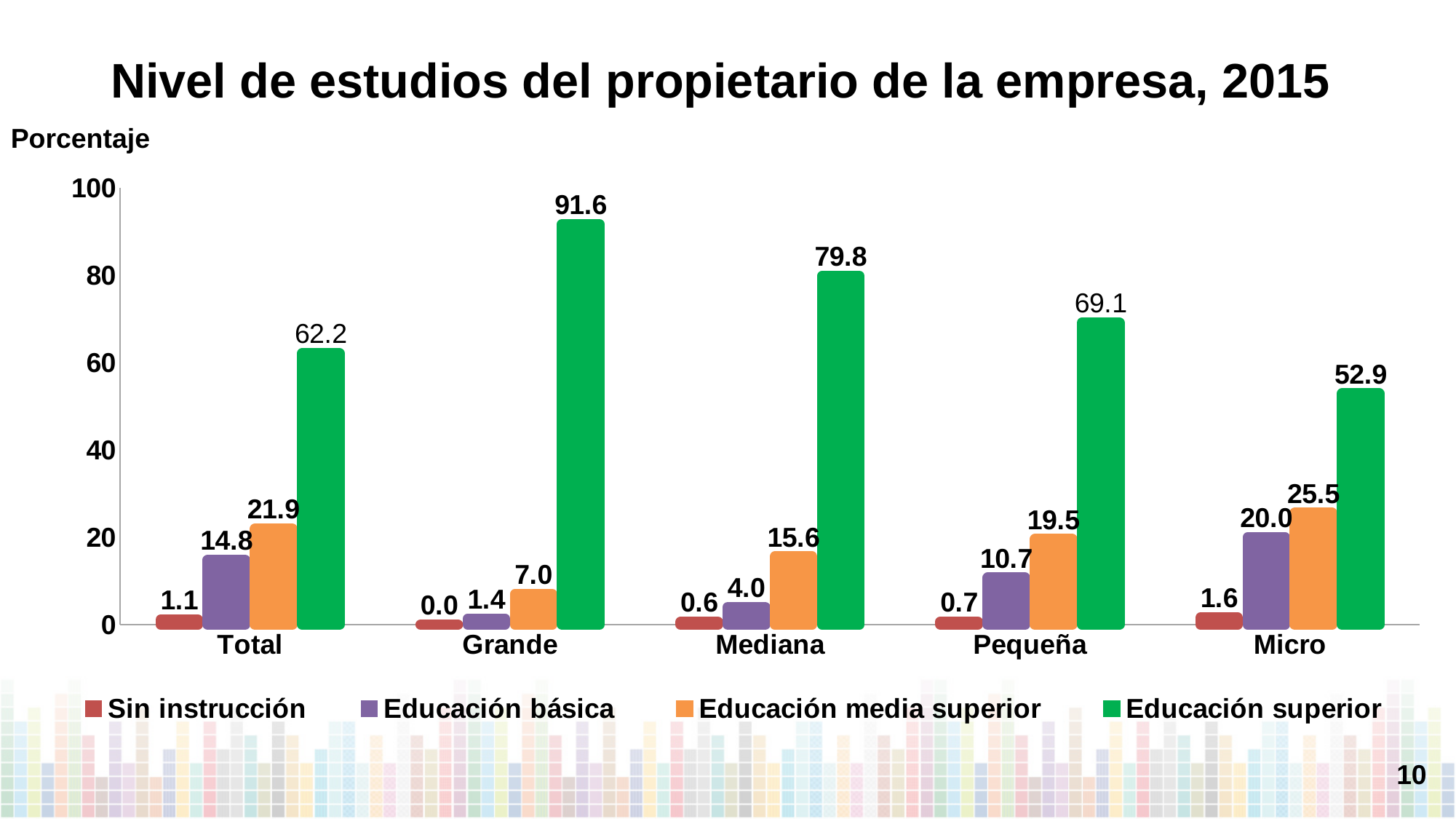
What is the title of the chart? Nivel de estudios del propietario de la empresa, 2015 Is the value for Educación superior in the Pequeña category greater or less than 60? greater Which category has the lowest value for Educación básica? Grande What kind of chart is shown on the slide? bar chart What is the value for Educación superior in the Grande category? 91.6 How many categories are shown on the x axis? 5 What is the value for Educación media superior in the Micro category? 25.5 What is the value for Sin instrucción in the Total category? 1.1 What is the difference between the Educación superior values for Grande and Micro? 38.7 Which is larger: Educación básica for Pequeña or Educación básica for Micro? Micro How many series does the legend list? 4 Which category has the highest value for Educación superior? Grande